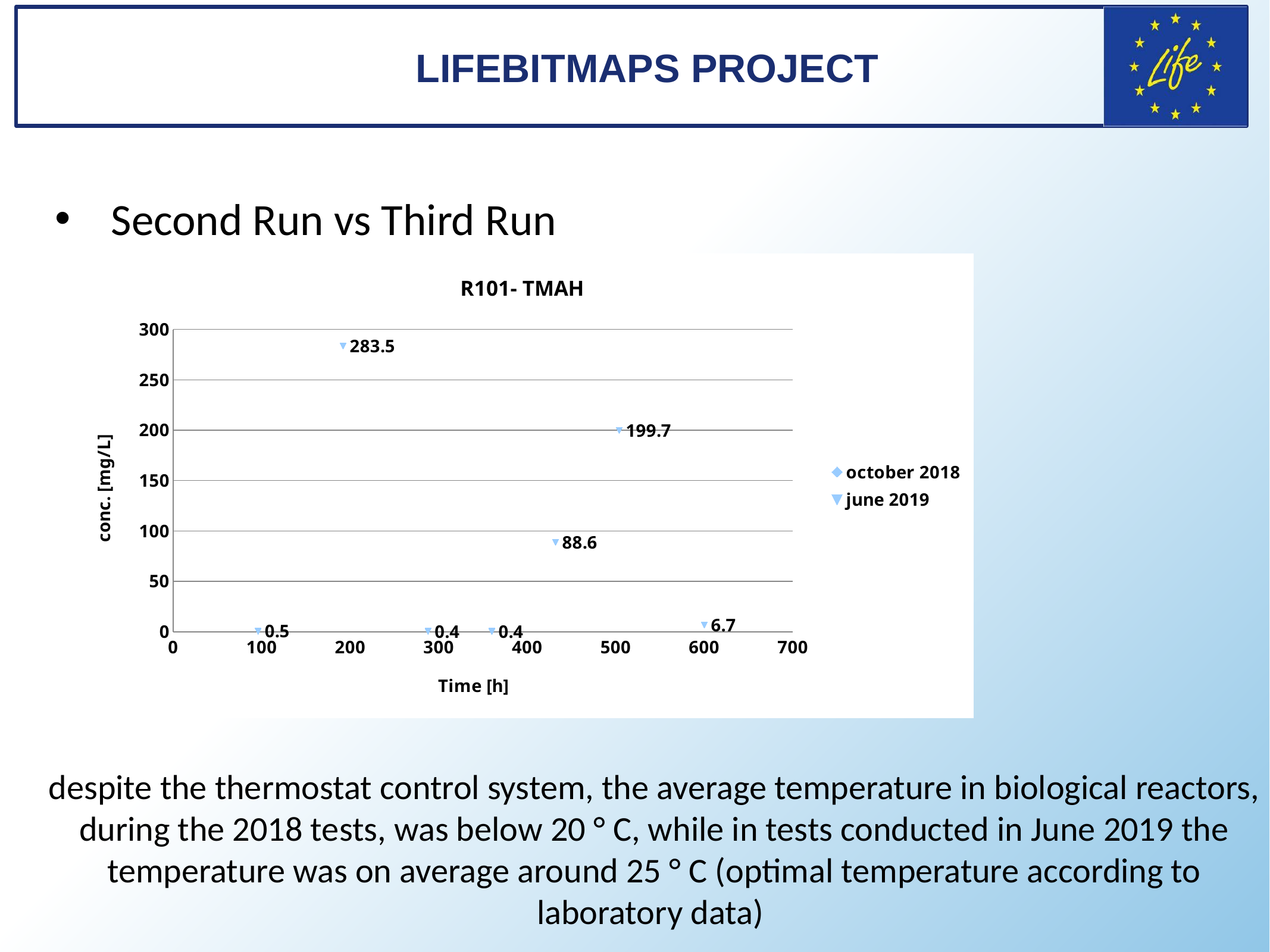
What is the highest labeled concentration value in the chart? 283.5 How many series does the legend list? 2 How many data points carry a printed value label in the chart? 7 What is the difference between the labeled values 199.7 and 88.6? 111.1 What is the label of the y axis? conc. [mg/L] What is the title of the chart? R101- TMAH Which is larger, the labeled value 88.6 or the labeled value 6.7? 88.6 What is the difference between the labeled values 283.5 and 199.7? 83.8 What kind of chart is shown on the slide? scatter chart Which series in the legend is shown with a triangle marker? june 2019 Is the highest labeled point in the chart greater or less than 250? greater What is the lowest labeled concentration value in the chart? 0.4